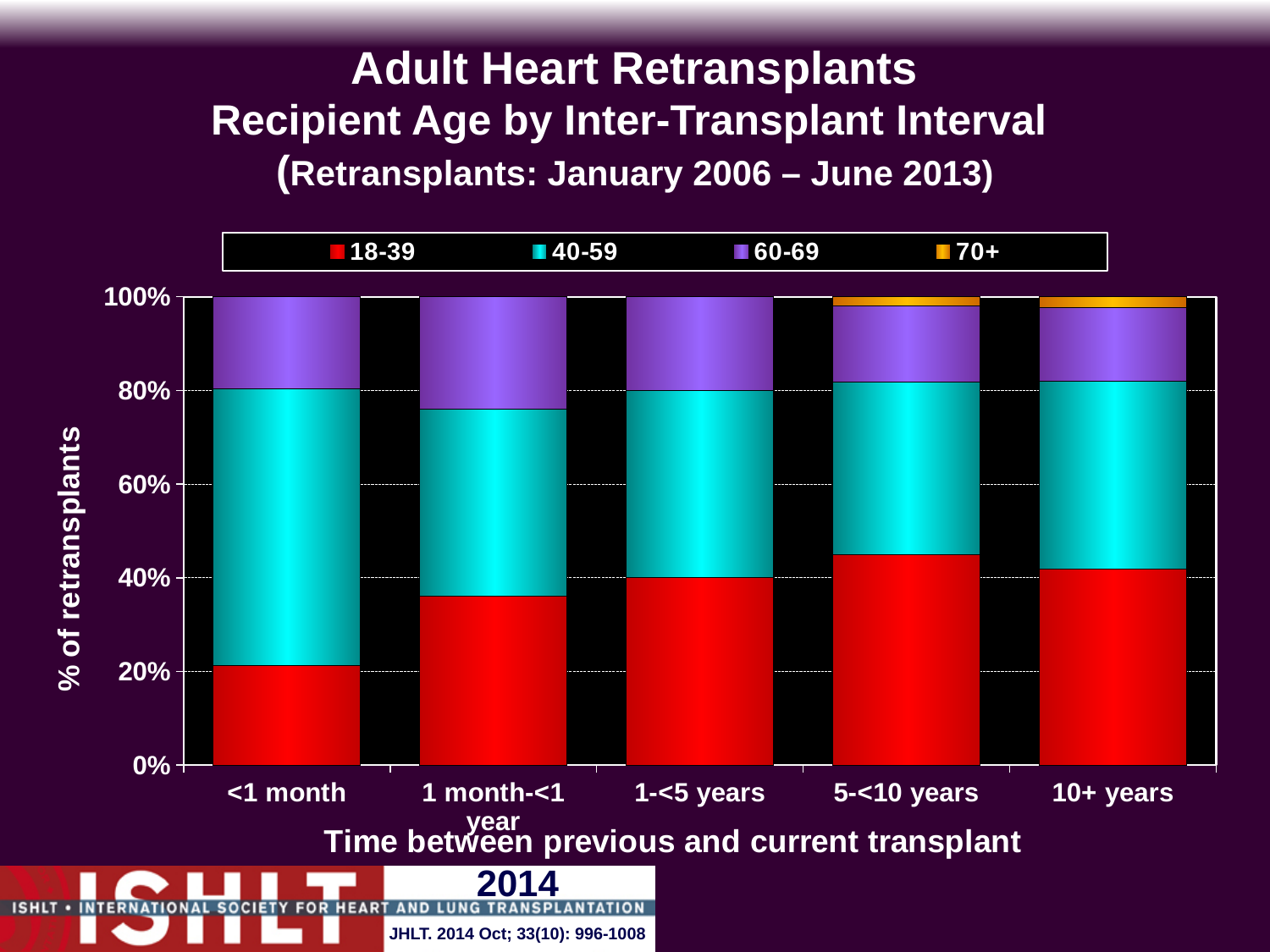
What kind of chart is shown on the slide? Stacked bar chart Which is larger, the 18-39 share for <1 month or for 10+ years? 10+ years Which inter-transplant interval has the smallest 18-39 share? <1 month Does the 18-39 share rise or fall from the <1 month interval to the 5-<10 years interval? rise What is the title of the x axis? Time between previous and current transplant How many age-group series does the legend list? 4 Which is larger, the 40-59 share for <1 month or for 10+ years? <1 month Is the 18-39 share for the 5-<10 years interval greater or less than 40%? greater How many inter-transplant interval categories are shown on the x axis? 5 Is the 18-39 share for the 1 month-<1 year interval greater or less than 40%? less Which age group is shown in red in the legend? 18-39 Is the 18-39 share for the <1 month interval greater or less than 40%? less